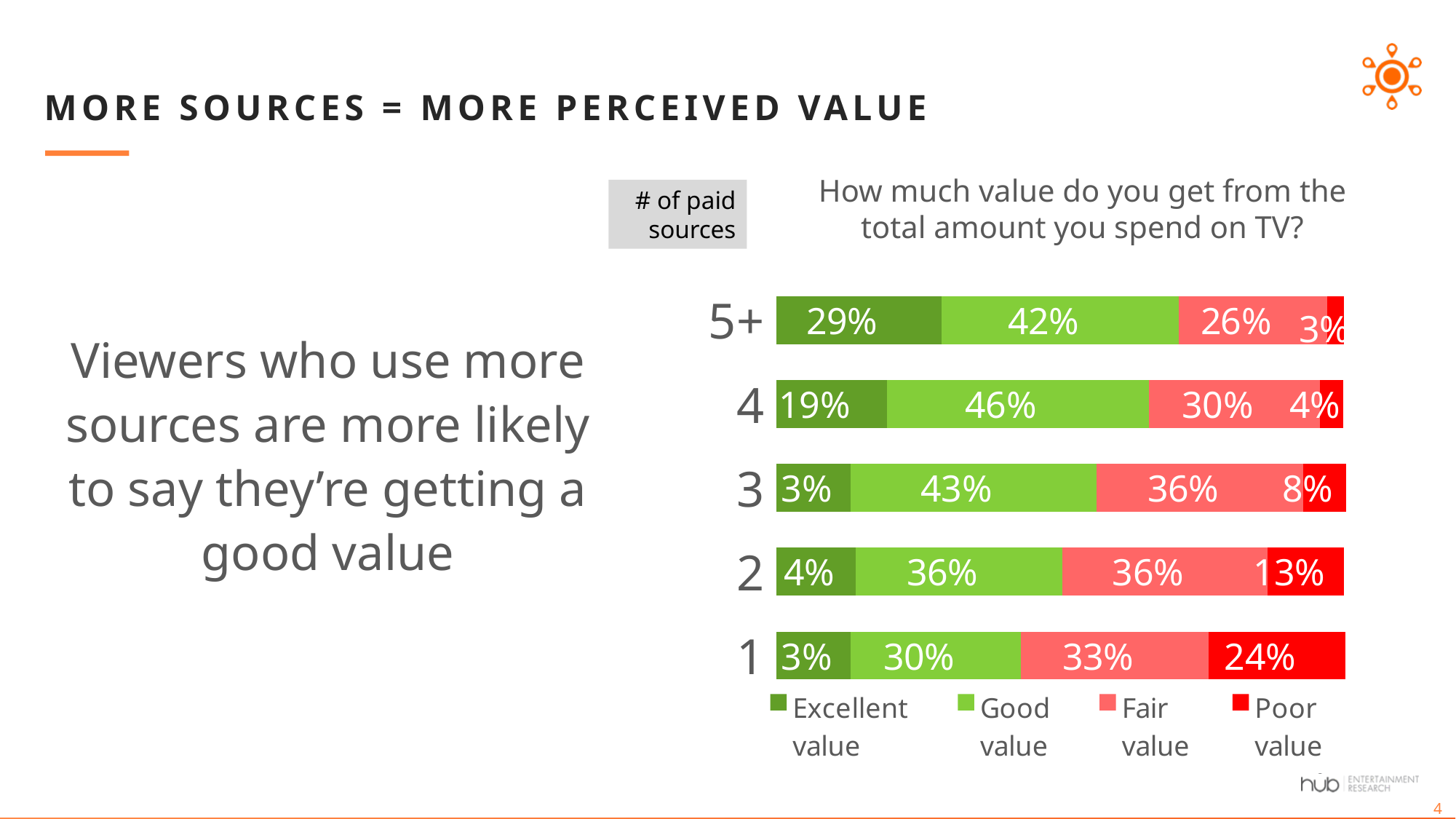
What is the Good value percentage for viewers with 4 paid sources? 46% What is the difference between the Poor value percentage for 1 paid source and for 2 paid sources? 11% What is the combined Excellent value and Good value percentage for viewers with 5+ paid sources? 71% Which number of paid sources has the highest Excellent value percentage? 5+ Which number of paid sources has the lowest Poor value percentage? 5+ What is the Fair value percentage for viewers with 3 paid sources? 36% What percentage of viewers with 5+ paid sources say they get excellent value? 29% What is the Poor value percentage for viewers with 1 paid source? 24% Which is larger: the Good value percentage for 2 paid sources or for 1 paid source? 2 paid sources How many categories (# of paid sources) are plotted? 5 How many series does the legend list? 4 What kind of chart is shown on the slide? Stacked bar chart